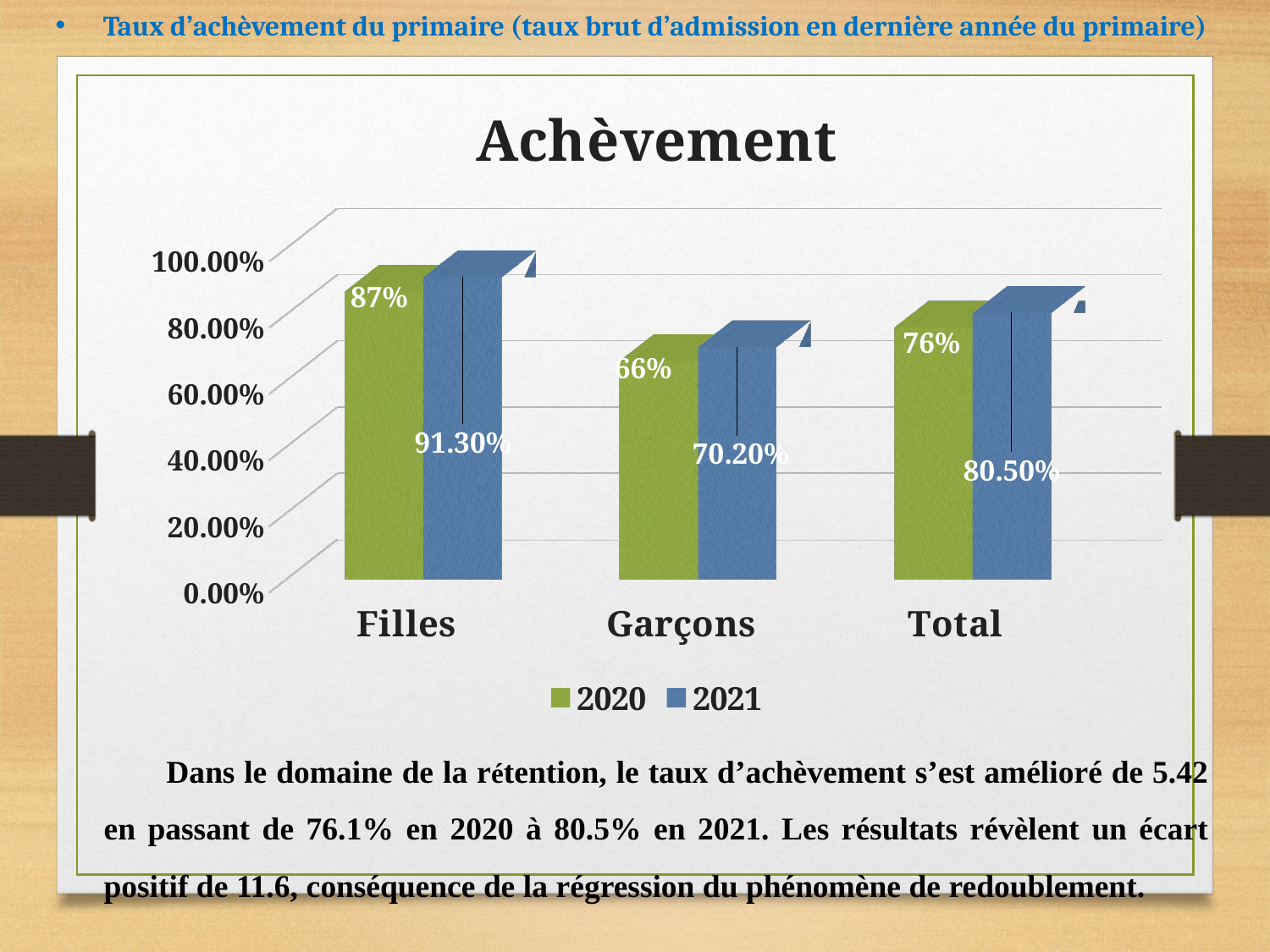
Which category has the lowest value in the 2021 series? Garçons What is the value for Filles in the 2021 series? 91.30% How many categories are shown on the x axis? 3 What is the value for Total in the 2021 series? 80.50% What is the value for Total in the 2020 series? 76% Which category has the highest value in the 2020 series? Filles What is the title of the chart? Achèvement What is the value for Garçons in the 2021 series? 70.20% How many series does the legend list? 2 What is the value for Filles in the 2020 series? 87% Which is larger for Garçons: the 2020 value or the 2021 value? 2021 Is the value for Garçons in 2020 greater or less than 80%? less